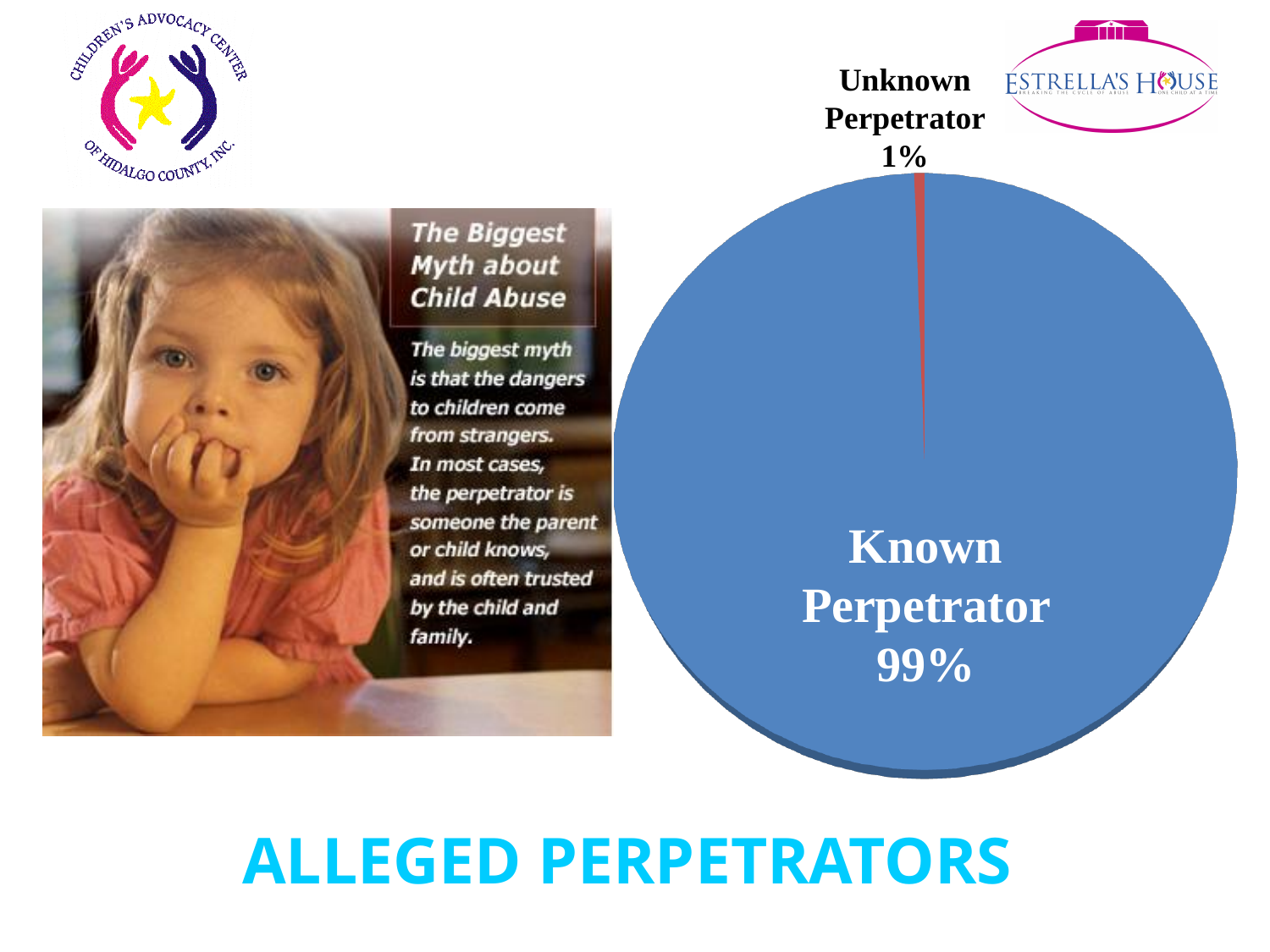
Which slice of the pie is the largest? Known Perpetrator Which is larger, Known Perpetrator or Unknown Perpetrator? Known Perpetrator Which slice of the pie is the smallest? Unknown Perpetrator What is the title shown below the pie chart? ALLEGED PERPETRATORS What is the difference in percentage points between Known Perpetrator and Unknown Perpetrator? 98 What share of the pie is Unknown Perpetrator? 1% What colour is the Known Perpetrator slice? Blue What kind of chart is shown on the slide? Pie chart What share of the pie is Known Perpetrator? 99% How many slices does the pie chart have? 2